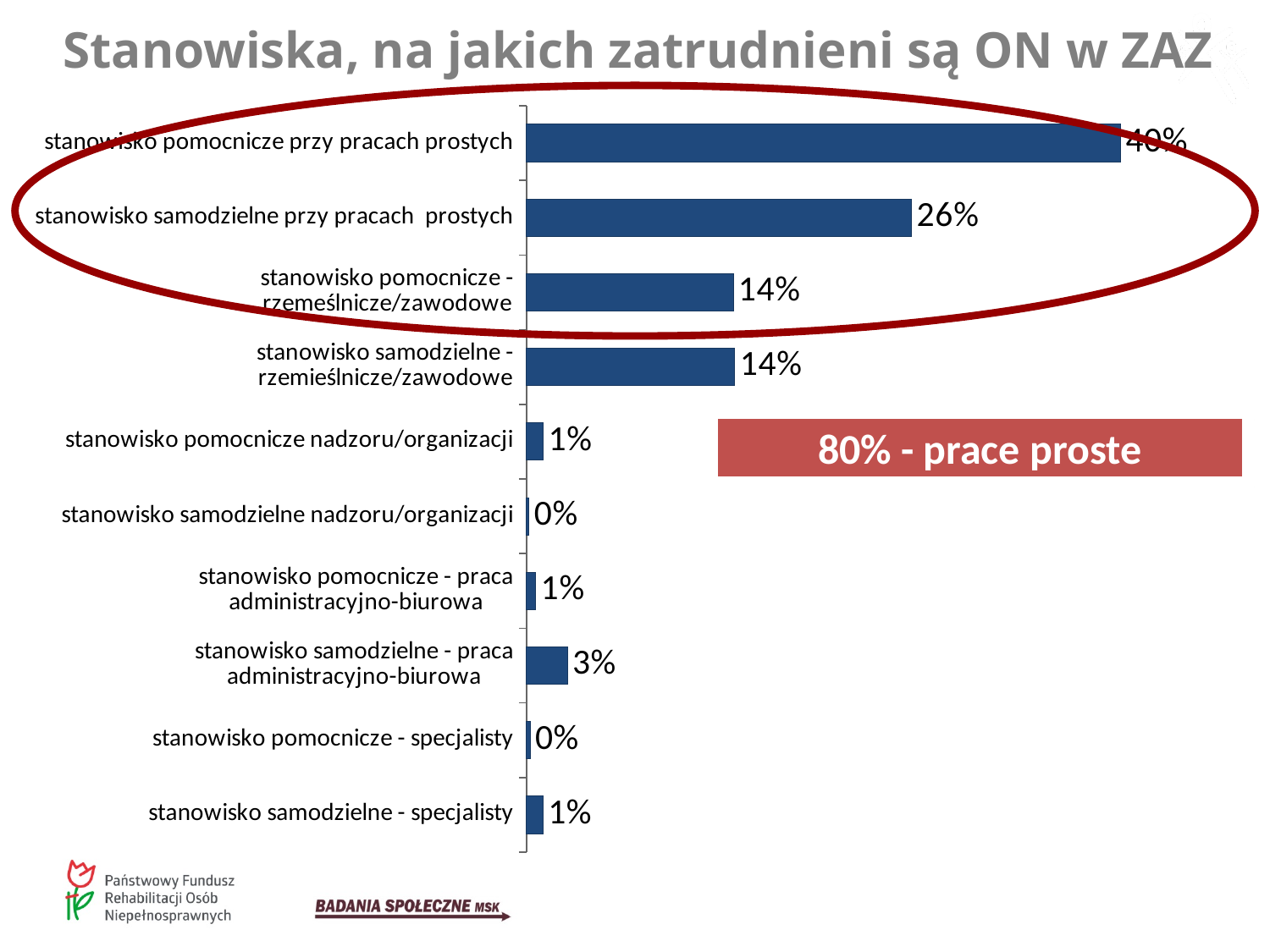
What is the value for 'stanowisko pomocnicze - rzemieślnicze/zawodowe'? 14% What is the value for 'stanowisko pomocnicze nadzoru/organizacji'? 1% What is the difference between 'stanowisko samodzielne przy pracach prostych' and 'stanowisko samodzielne - rzemieślnicze/zawodowe'? 12% Which category has the highest value? stanowisko pomocnicze przy pracach prostych How many categories are shown in the chart? 10 What is the value for 'stanowisko samodzielne przy pracach prostych'? 26% What is the difference between 'stanowisko samodzielne - praca administracyjno-biurowa' and 'stanowisko pomocnicze - praca administracyjno-biurowa'? 2% What type of chart is shown on the slide? bar chart What text is shown in the red callout box on the chart? 80% - prace proste Which is larger: 'stanowisko samodzielne - praca administracyjno-biurowa' or 'stanowisko samodzielne - specjalisty'? stanowisko samodzielne - praca administracyjno-biurowa What is the value for 'stanowisko pomocnicze - specjalisty'? 0% What is the value for 'stanowisko samodzielne - praca administracyjno-biurowa'? 3%